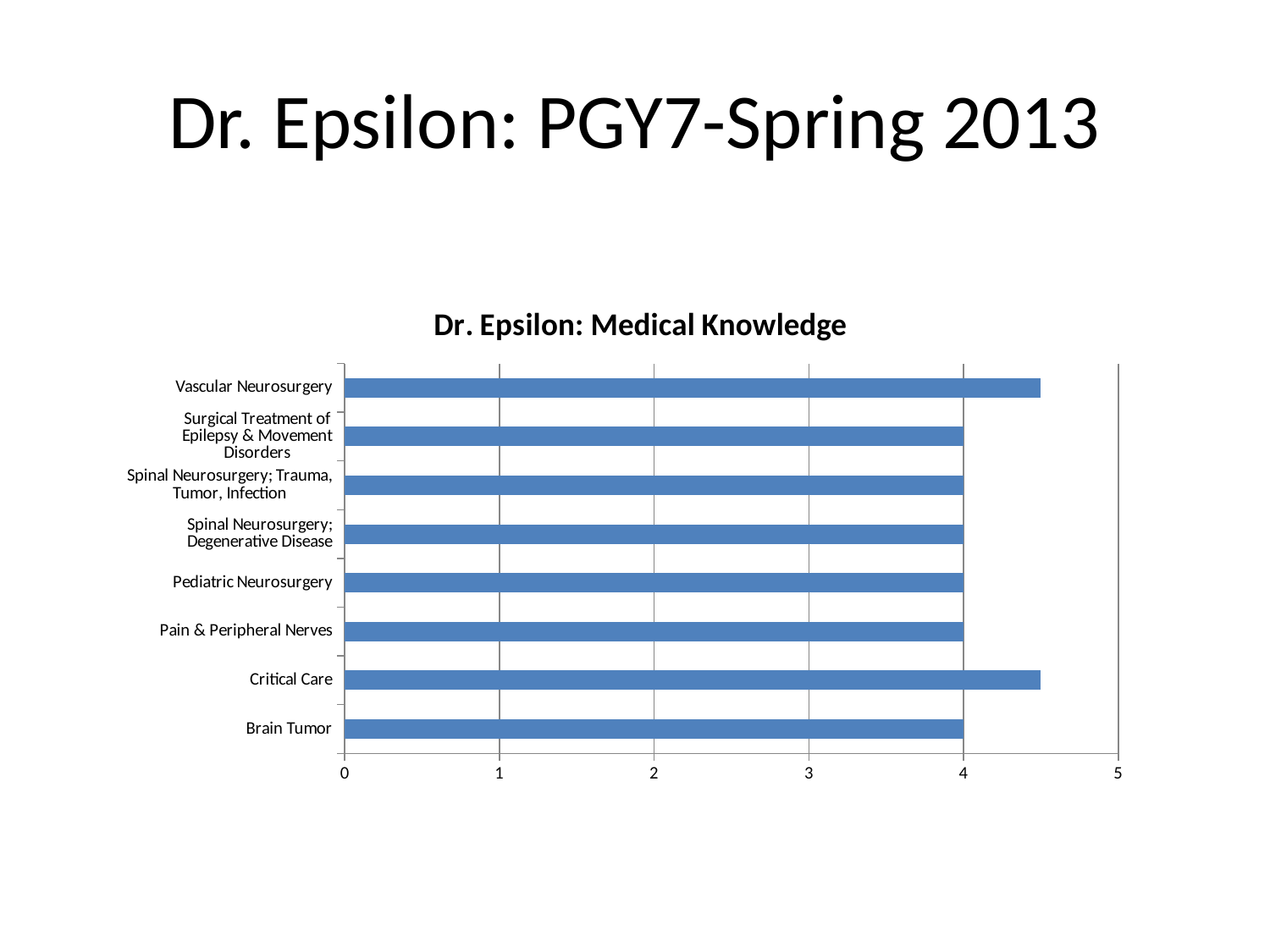
What kind of chart is shown on the slide? bar chart Is the value for Vascular Neurosurgery greater or less than 4? greater How many categories are plotted in the chart? 8 What is the value for Pediatric Neurosurgery? 4 What is the title of the chart? Dr. Epsilon: Medical Knowledge Which is larger, the value for Vascular Neurosurgery or the value for Pediatric Neurosurgery? Vascular Neurosurgery What is the value for Pain & Peripheral Nerves? 4 What is the value for Spinal Neurosurgery; Degenerative Disease? 4 Is the value for Critical Care greater or less than 5? less What is the value for Brain Tumor? 4 What is the maximum value shown on the horizontal axis? 5 Which is larger, the value for Critical Care or the value for Brain Tumor? Critical Care